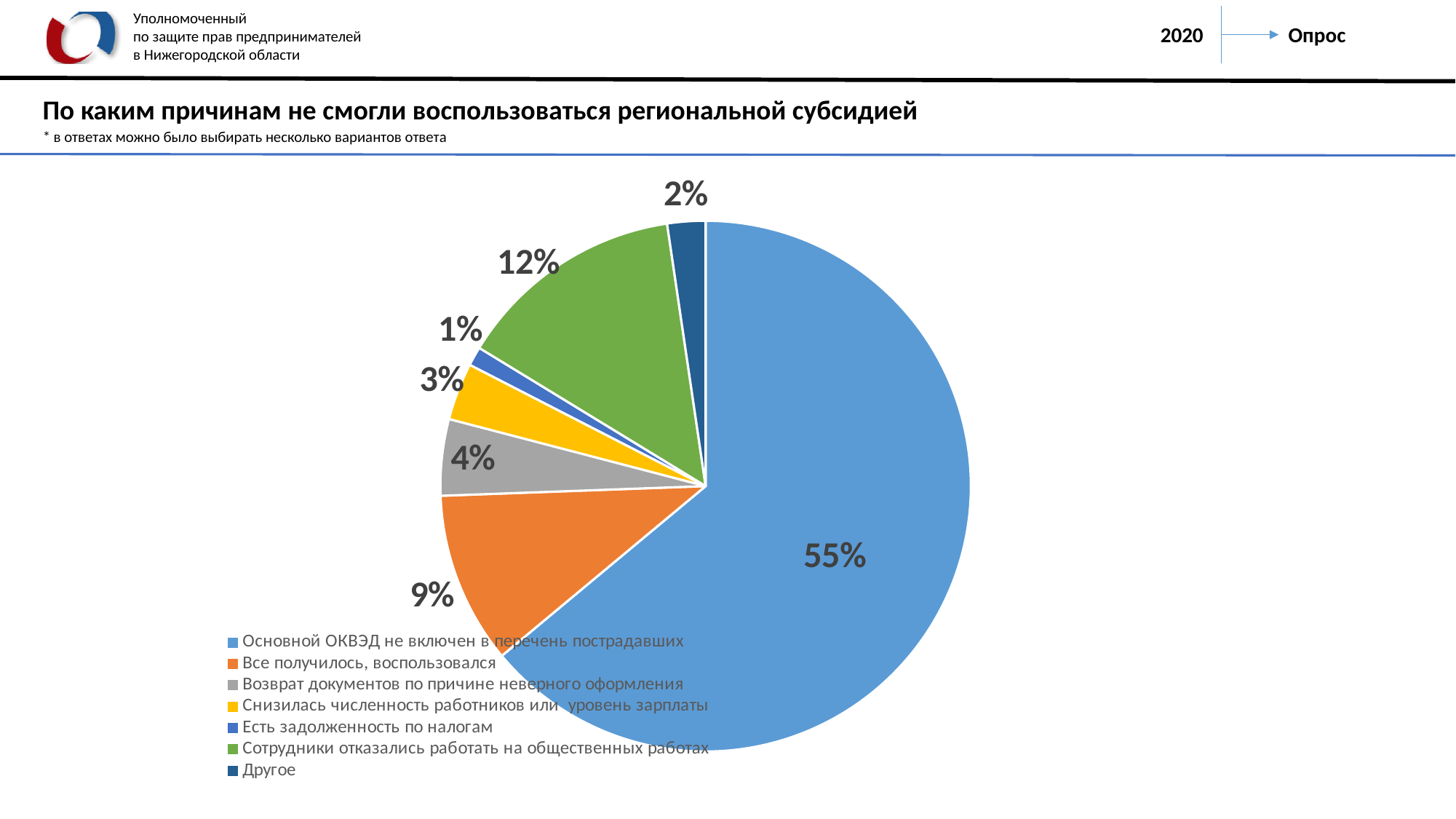
What is the value for "Сотрудники отказались работать на общественных работах"? 12% What share of the pie does "Основной ОКВЭД не включен в перечень пострадавших" have? 55% How many categories does the pie chart have? 7 Which category has the largest slice of the pie? Основной ОКВЭД не включен в перечень пострадавших What is the value for "Все получилось, воспользовался"? 9% What is the difference between the values for "Сотрудники отказались работать на общественных работах" and "Все получилось, воспользовался"? 3% What is the value for "Есть задолженность по налогам"? 1% What colour is the slice for "Снизилась численность работников или уровень зарплаты"? Yellow What kind of chart is shown on the slide? Pie chart Which category has the smallest slice of the pie? Есть задолженность по налогам What is the value for "Другое"? 2% Which is larger: "Возврат документов по причине неверного оформления" or "Снизилась численность работников или уровень зарплаты"? Возврат документов по причине неверного оформления